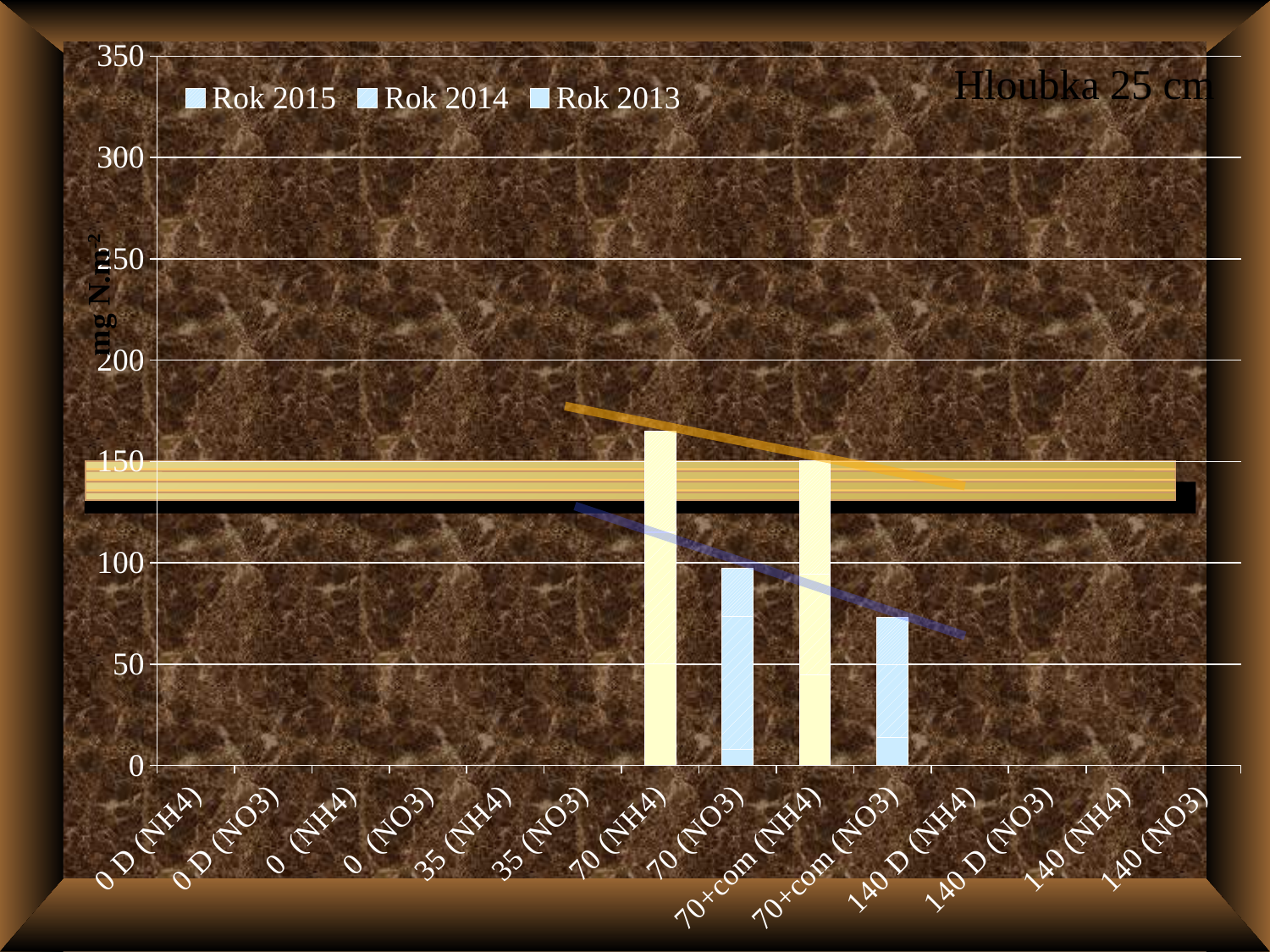
Is the value of the bar for 70 (NO3) greater or less than 150? less Is the value of the bar for 70+com (NO3) greater or less than 100? less What is the title shown in the top right corner of the chart? Hloubka 25 cm Which bar is taller, 70 (NH4) or 70 (NO3)? 70 (NH4) How many categories are shown on the x axis? 14 What kind of chart is shown on the slide? bar chart How many series does the legend list? 3 Is the value of the bar for 70 (NH4) greater or less than 150? greater Which bar is taller, 70+com (NH4) or 70+com (NO3)? 70+com (NH4) What are the three legend entries of the chart? Rok 2015, Rok 2014, Rok 2013 Which category has the tallest bar on the chart? 70 (NH4)